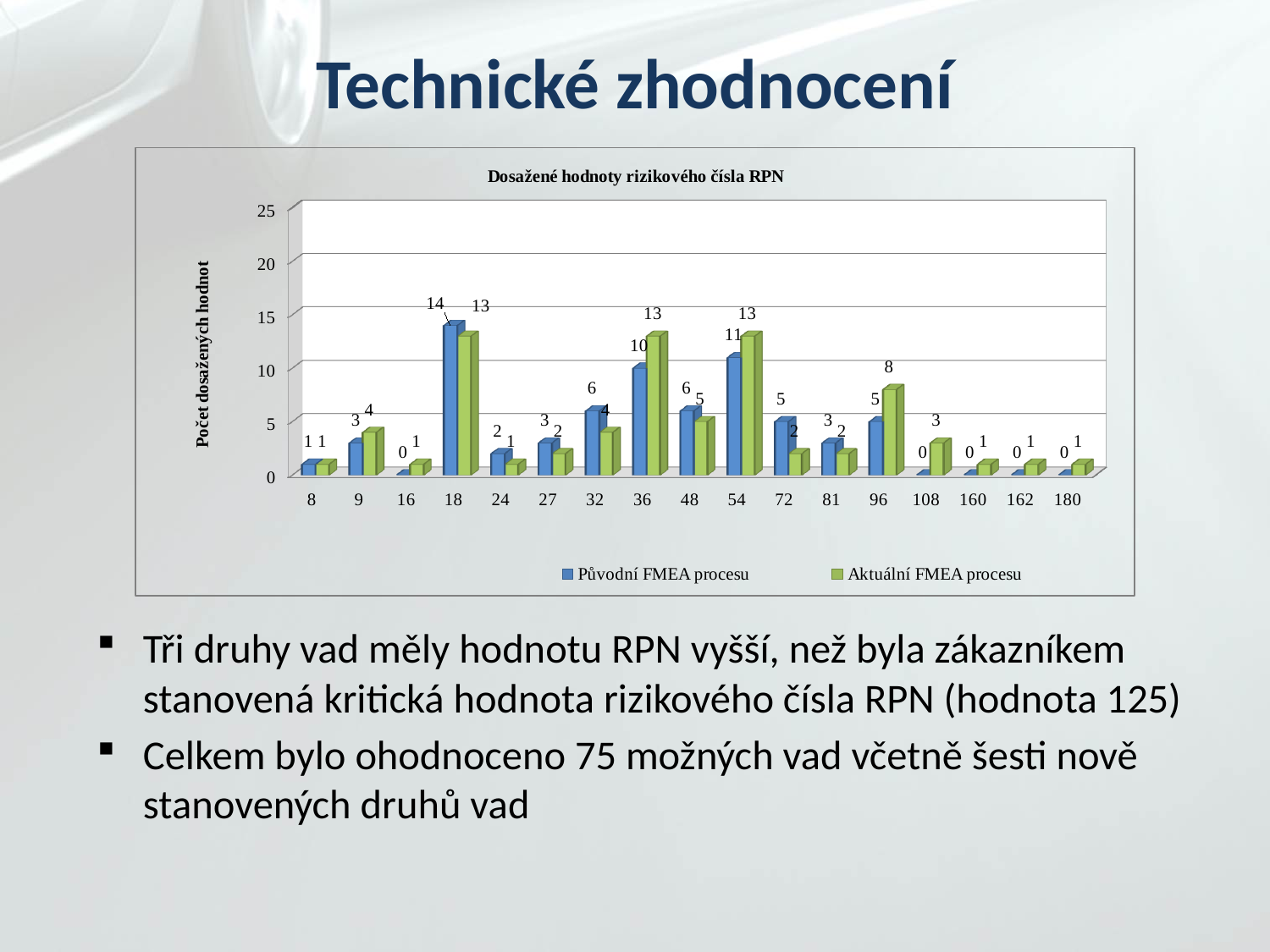
What is the value of Aktuální FMEA procesu for RPN 108? 3 What is the value of Aktuální FMEA procesu for RPN 96? 8 What is the difference between Aktuální FMEA procesu and Původní FMEA procesu for RPN 36? 3 What is the value of Původní FMEA procesu for RPN 160? 0 What is the value of Původní FMEA procesu for RPN 18? 14 What type of chart is shown on the slide? bar chart Which RPN category has the highest value for Původní FMEA procesu? 18 How many RPN categories are shown on the x axis? 17 What is the title of the chart? Dosažené hodnoty rizikového čísla RPN How many series does the legend list? 2 For RPN 72, which series has the larger value, Původní FMEA procesu or Aktuální FMEA procesu? Původní FMEA procesu Is the value of Původní FMEA procesu for RPN 54 greater or less than 10? greater